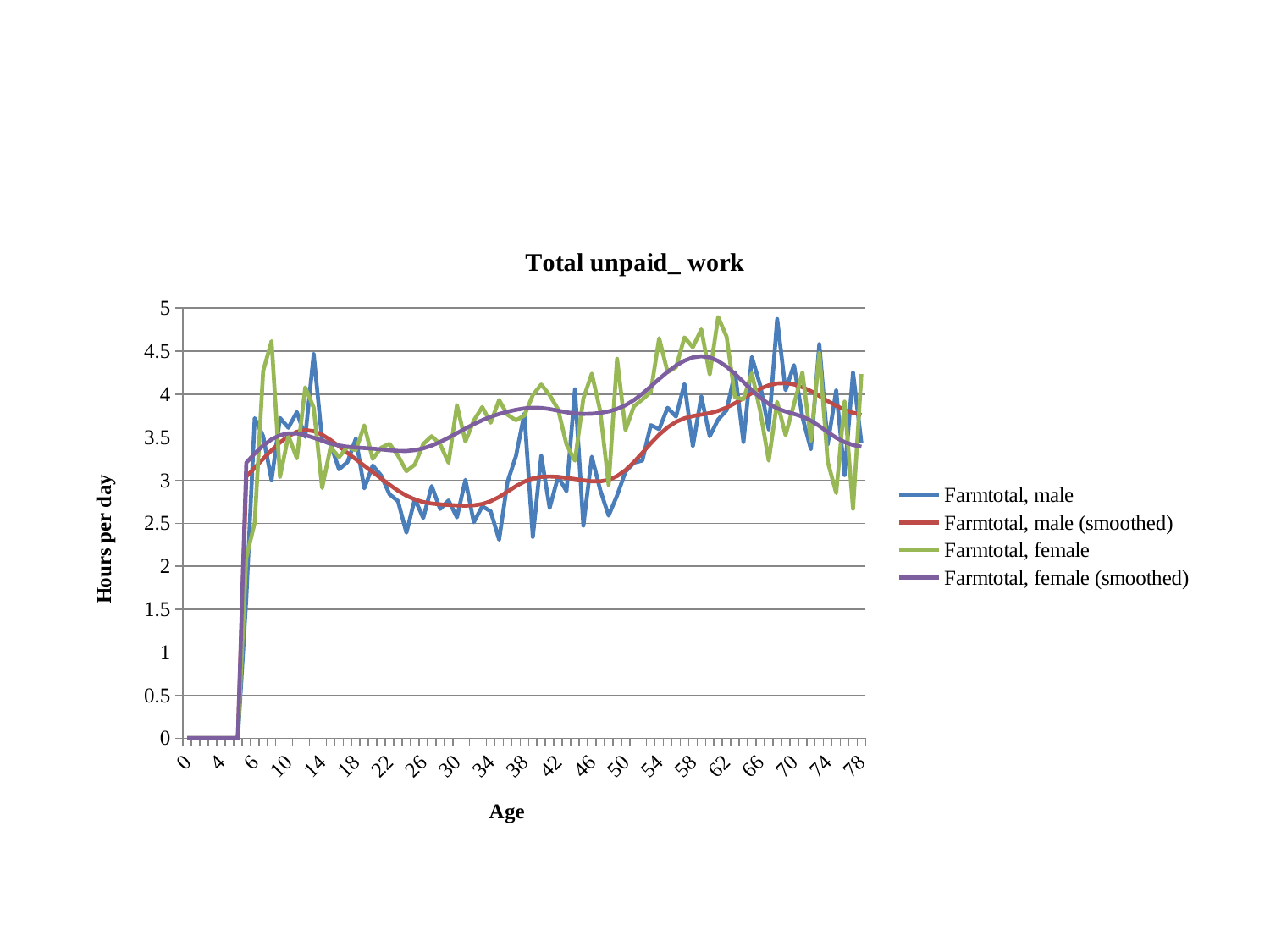
Does the Farmtotal, female (smoothed) line rise or fall between age 62 and age 78? fall What kind of chart is shown on the slide? line chart Does the Farmtotal, male (smoothed) line rise or fall between age 50 and age 60? rise Is the value for Farmtotal, male (smoothed) at age 30 greater or less than 3? less How many series does the legend list? 4 What is the title of the chart? Total unpaid_ work Is the value for Farmtotal, female (smoothed) at age 60 greater or less than 4? greater What is the value for Farmtotal, male at age 2? 0 What is the label of the vertical axis? Hours per day Is the value for Farmtotal, female (smoothed) at age 30 greater or less than 3? greater At age 30, which is higher: Farmtotal, male (smoothed) or Farmtotal, female (smoothed)? Farmtotal, female (smoothed)